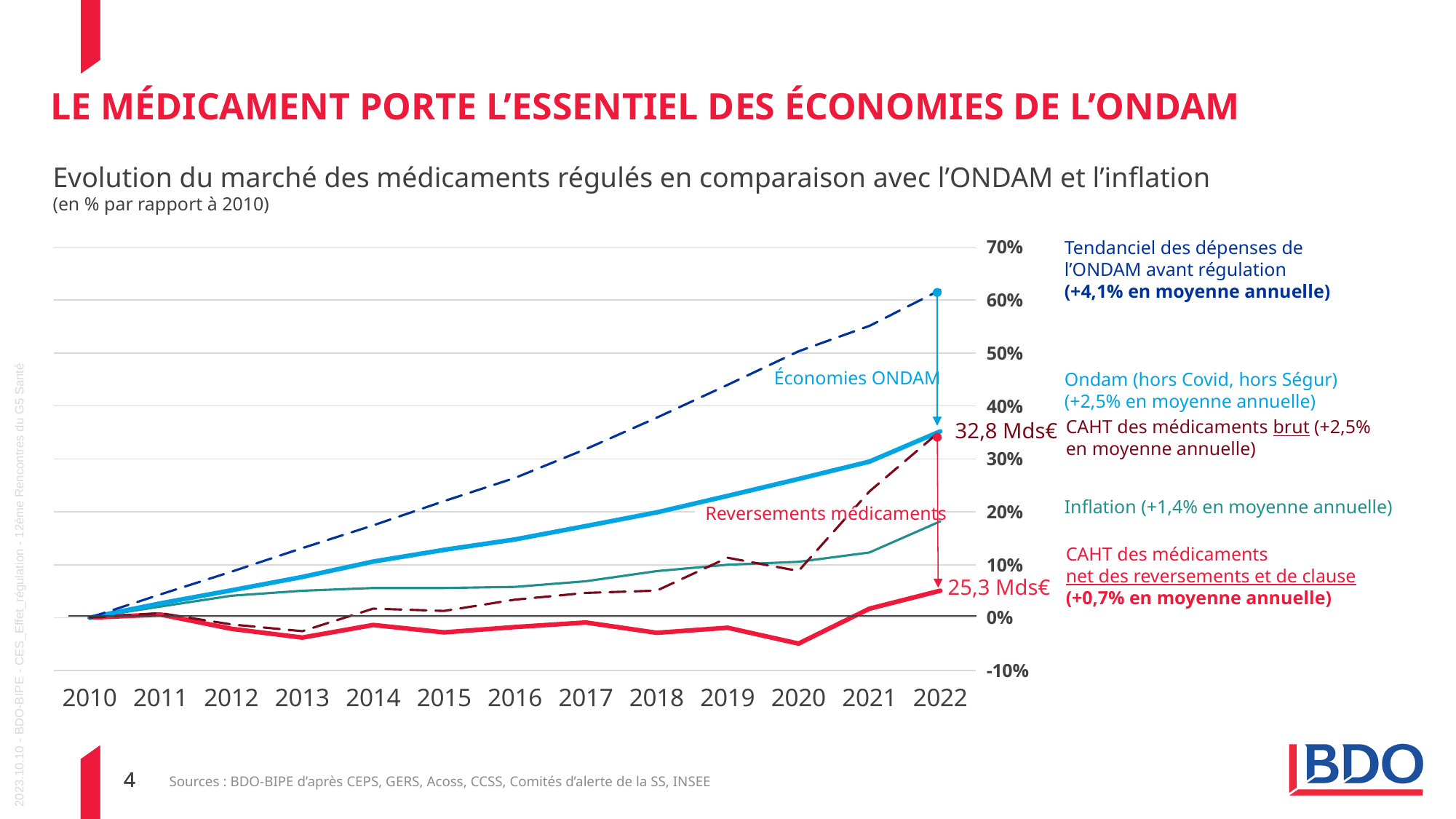
Which series has the lowest value in 2022? CAHT des médicaments net des reversements et de clause Is the 2020 value for CAHT des médicaments net des reversements et de clause greater or less than 0%? less What amount is annotated next to the arrow labelled Reversements médicaments at the top of the 2022 values? 32,8 Mds€ Is the 2022 value for Tendanciel des dépenses de l'ONDAM avant régulation greater or less than 50%? greater Does the Tendanciel des dépenses de l'ONDAM avant régulation series rise or fall from 2010 to 2022? rise In 2022, which is higher: Ondam (hors Covid, hors Ségur) or Inflation? Ondam (hors Covid, hors Ségur) How many series does the chart's legend list? 5 Is the 2022 value for Inflation greater or less than 20%? less What kind of chart is shown on the slide? line chart How many years are shown along the x axis of the chart? 13 Which series has the highest value in 2022? Tendanciel des dépenses de l'ONDAM avant régulation